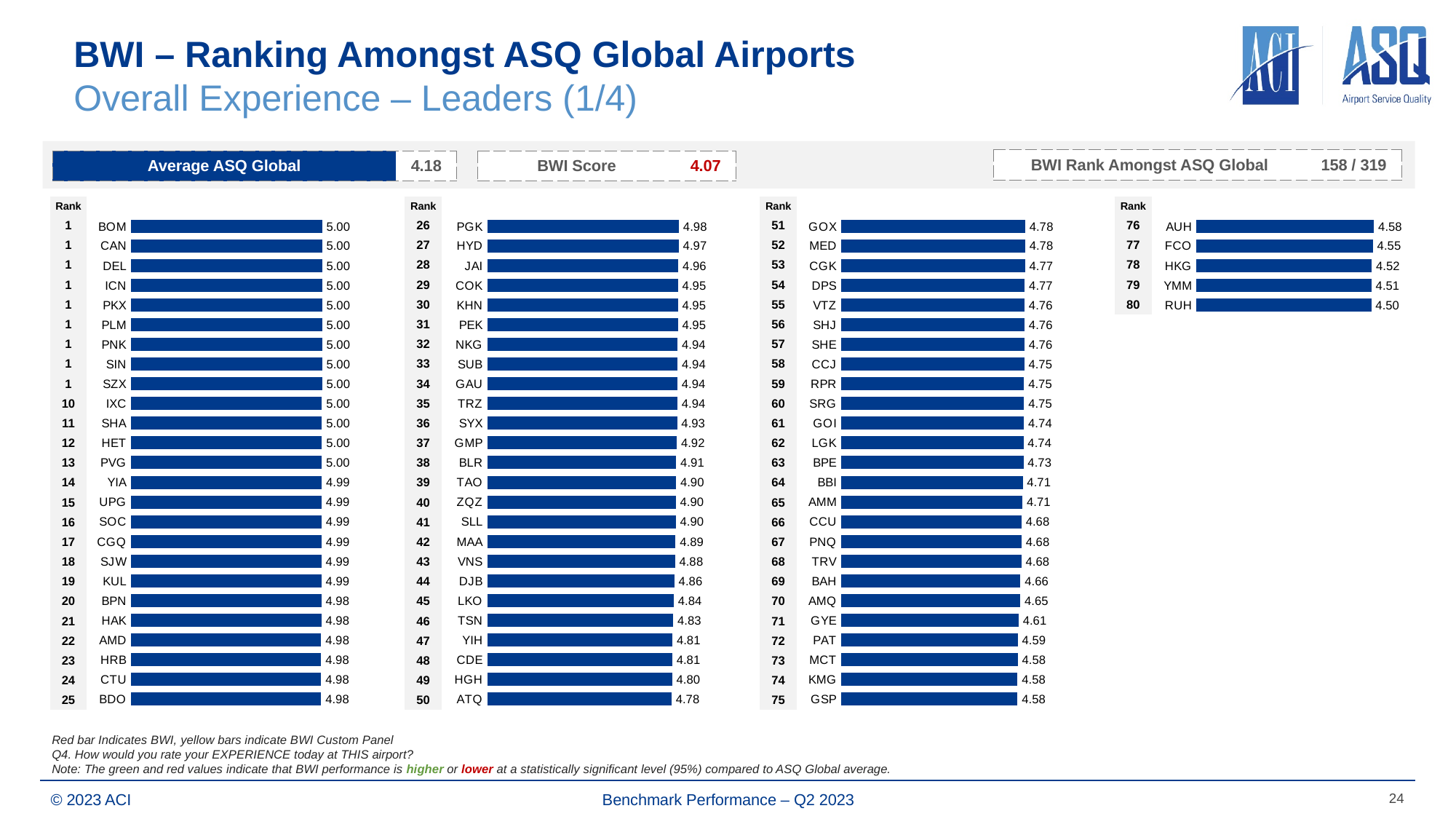
In the third chart from the left (ranks 51–75), what is the value for BAH? 4.66 In the second chart from the left (ranks 26–50), what is the difference between the values for PGK and ATQ? 0.20 In the leftmost chart (ranks 1–25), what is the value for BOM? 5.00 In the second chart from the left (ranks 26–50), which is larger, the value for HYD or the value for BLR? HYD What BWI Score is shown in the box at the top of the slide? 4.07 In the third chart from the left (ranks 51–75), do the values rise or fall going down the list from rank 51 to rank 75? Fall In the second chart from the left (ranks 26–50), what is the value for ATQ? 4.78 In the second chart from the left (ranks 26–50), which airport has the highest value? PGK In the rightmost chart (ranks 76–80), which airport has the lowest value? RUH In the rightmost chart (ranks 76–80), what is the value for RUH? 4.50 What kind of chart is used to show the airport scores on this slide? Bar chart How many airports are shown in the rightmost chart (ranks 76–80)? 5